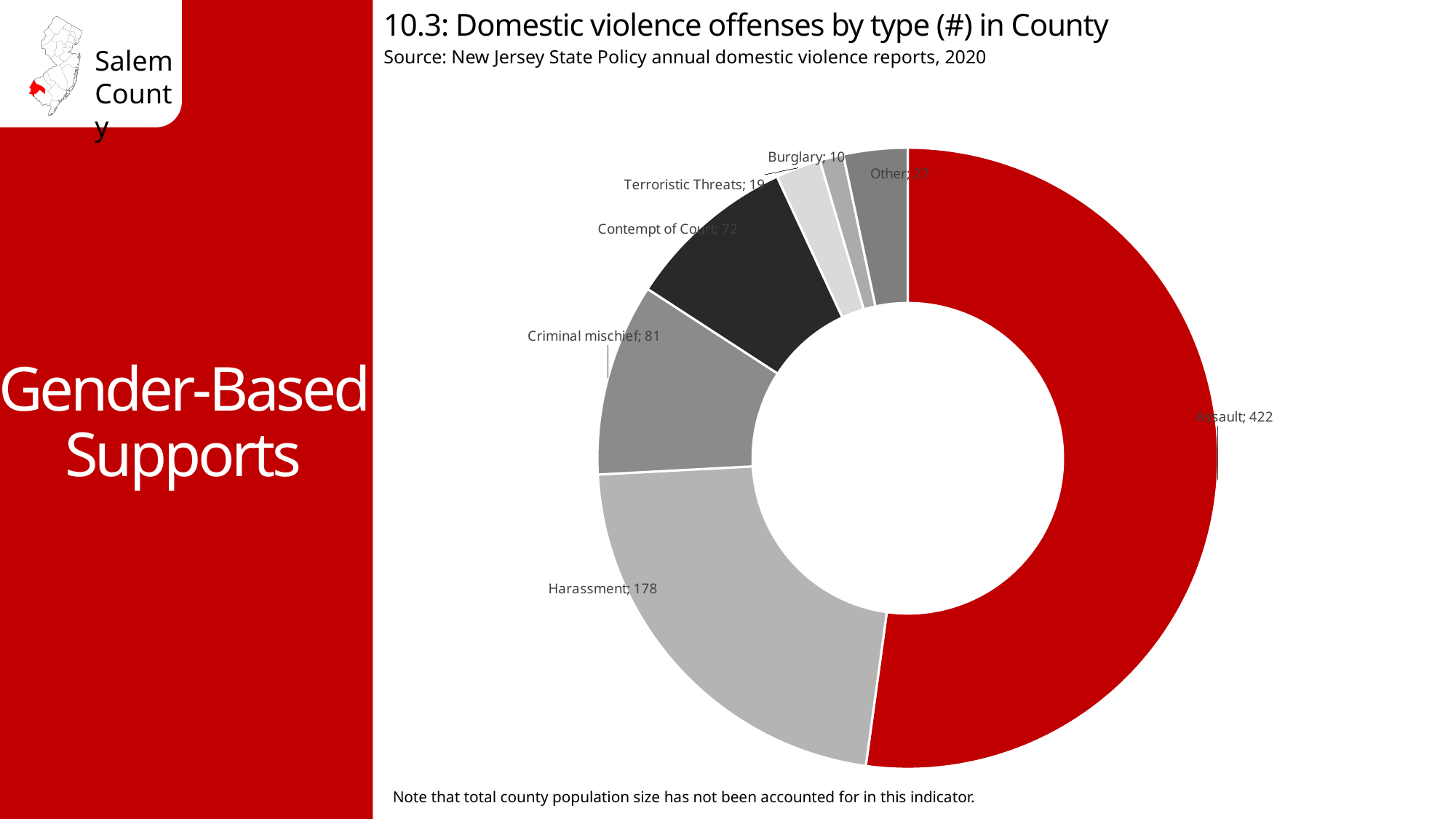
What is the source cited for the chart? New Jersey State Policy annual domestic violence reports, 2020 What is the value shown for Harassment? 178 What is the value shown for Criminal mischief? 81 What is the value shown for Burglary? 10 What kind of chart is shown on the slide? Doughnut chart What is the difference between the Assault and Harassment values? 244 Which is larger, the value for Other or the value for Terroristic Threats? Other What is the value shown for Contempt of Court? 72 How many domestic violence offenses of type Assault are shown on the chart? 422 How many offense types (slices) are shown on the chart? 7 Which offense type has the lowest number of offenses? Burglary Which offense type has the highest number of offenses? Assault